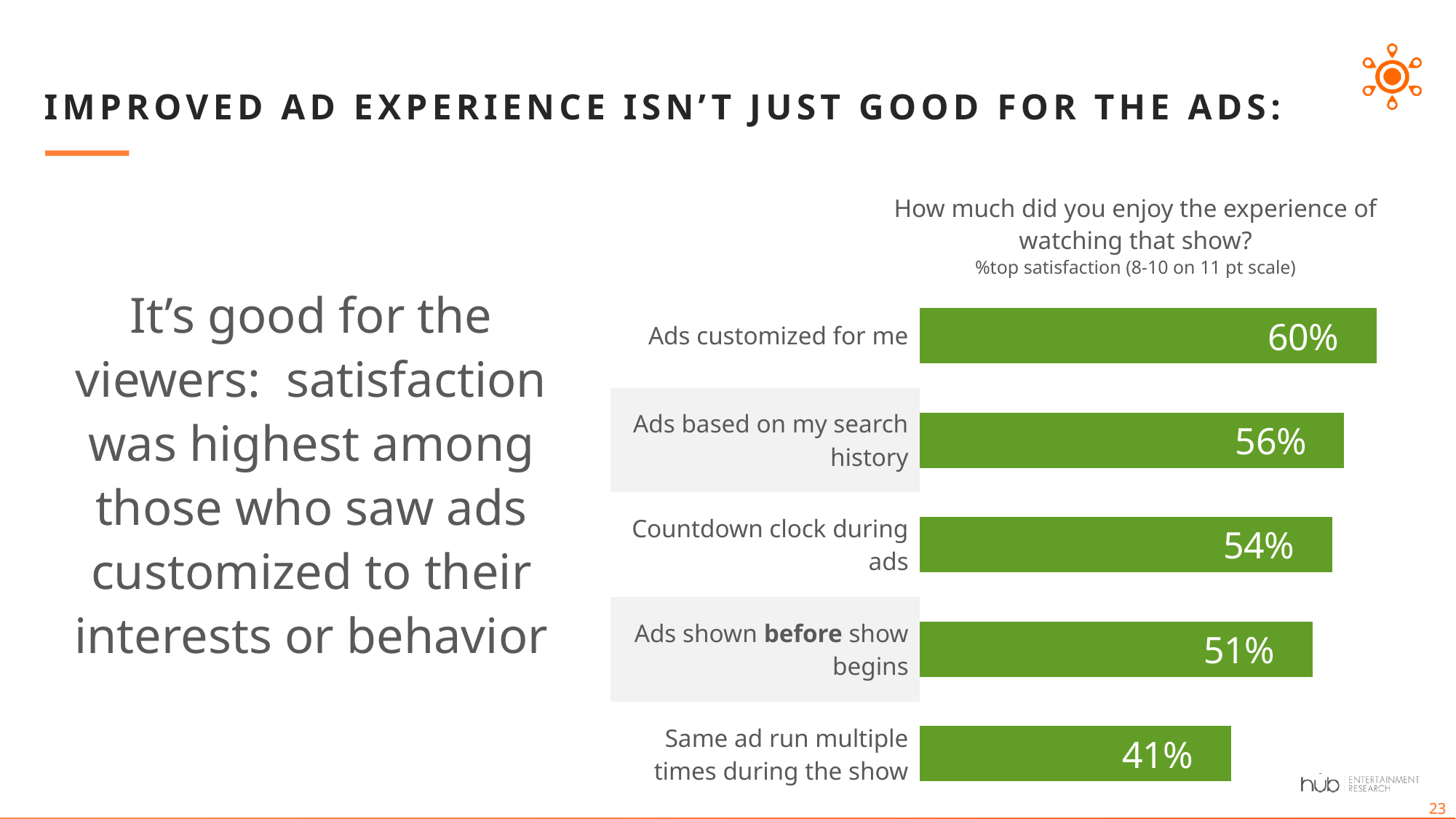
What is the value for "Ads customized for me"? 60% How many categories are shown in the chart? 5 Which is larger: "Countdown clock during ads" or "Ads shown before show begins"? Countdown clock during ads What kind of chart is shown on the slide? Bar chart Which category has the highest value? Ads customized for me What is the difference between "Ads customized for me" and "Same ad run multiple times during the show"? 19% Which category has the lowest value? Same ad run multiple times during the show What is the value for "Same ad run multiple times during the show"? 41% What is the difference between "Ads based on my search history" and "Ads shown before show begins"? 5% What is the title of the chart? How much did you enjoy the experience of watching that show? What is the value for "Countdown clock during ads"? 54% What is the value for "Ads based on my search history"? 56%